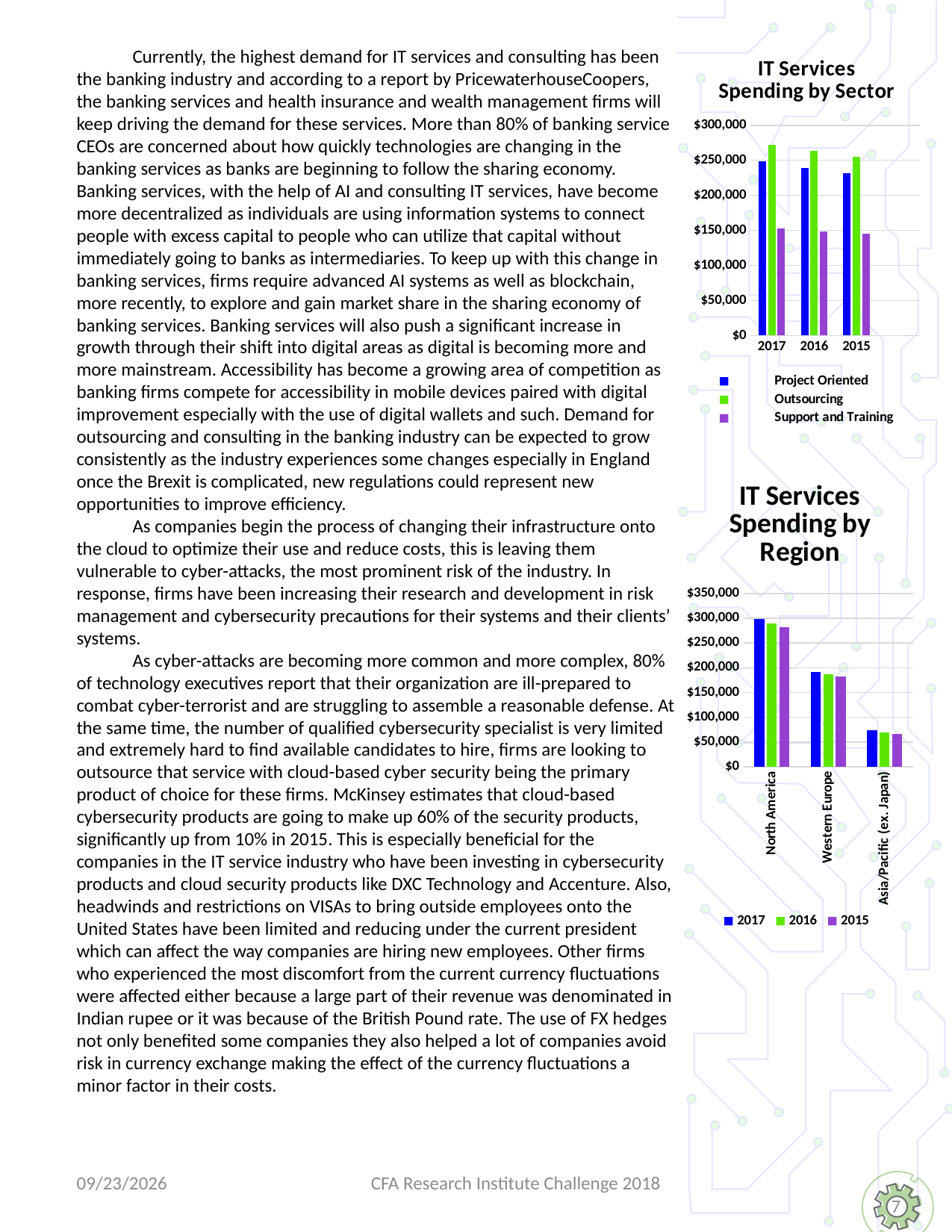
In the 'IT Services Spending by Sector' chart, is the value for Support and Training in 2017 greater or less than $200,000? less What kind of chart is the 'IT Services Spending by Sector' chart? bar chart How many regions are shown on the x axis of the 'IT Services Spending by Region' chart? 3 In the 'IT Services Spending by Sector' chart, which series has the highest value in 2017? Outsourcing In the 'IT Services Spending by Region' chart, which region has the lowest spending? Asia/Pacific (ex. Japan) In the 'IT Services Spending by Region' chart, which region has the highest spending? North America In the 'IT Services Spending by Sector' chart, which series has the lowest value in 2015? Support and Training In the 'IT Services Spending by Sector' chart, which is larger in 2017: Project Oriented or Support and Training? Project Oriented In the 'IT Services Spending by Sector' chart, is the value for Outsourcing in 2017 greater or less than $250,000? greater How many series does the legend of the 'IT Services Spending by Sector' chart list? 3 In the 'IT Services Spending by Region' chart, is the value for Asia/Pacific (ex. Japan) in 2017 greater or less than $100,000? less